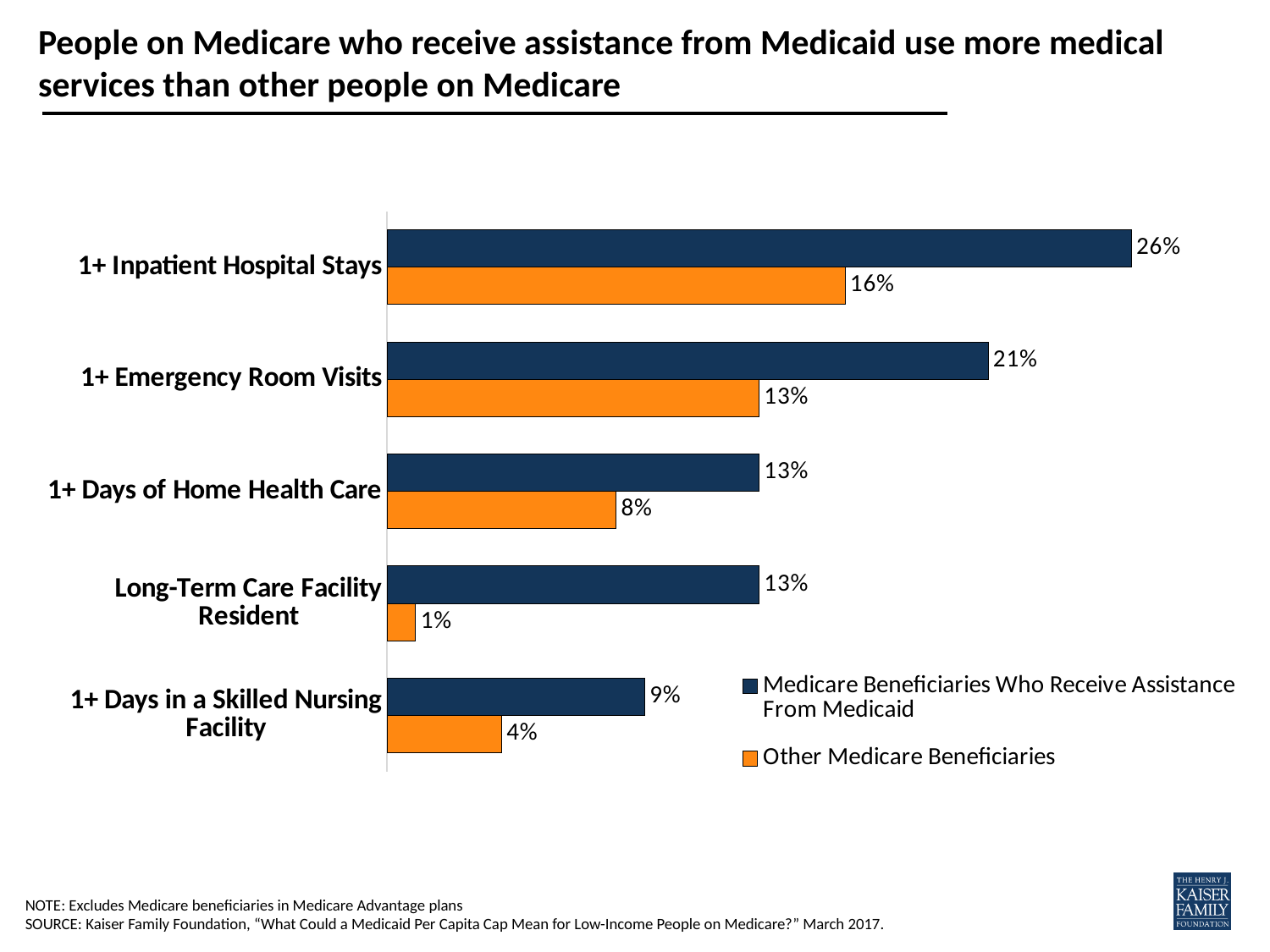
Which colour represents Other Medicare Beneficiaries in the chart? Orange What percentage of Other Medicare Beneficiaries had 1+ Emergency Room Visits? 13% What is the difference between the two series for Long-Term Care Facility Resident? 12 percentage points What is the difference between the two series for 1+ Inpatient Hospital Stays? 10 percentage points What percentage of Medicare Beneficiaries Who Receive Assistance From Medicaid had 1+ Inpatient Hospital Stays? 26% How many series does the legend list? 2 Which category has the highest value for Medicare Beneficiaries Who Receive Assistance From Medicaid? 1+ Inpatient Hospital Stays What kind of chart is shown on the slide? Bar chart How many categories are shown on the chart? 5 For 1+ Days of Home Health Care, which series has the larger value? Medicare Beneficiaries Who Receive Assistance From Medicaid Which category has the lowest value for Other Medicare Beneficiaries? Long-Term Care Facility Resident What is the value for Other Medicare Beneficiaries for Long-Term Care Facility Resident? 1%